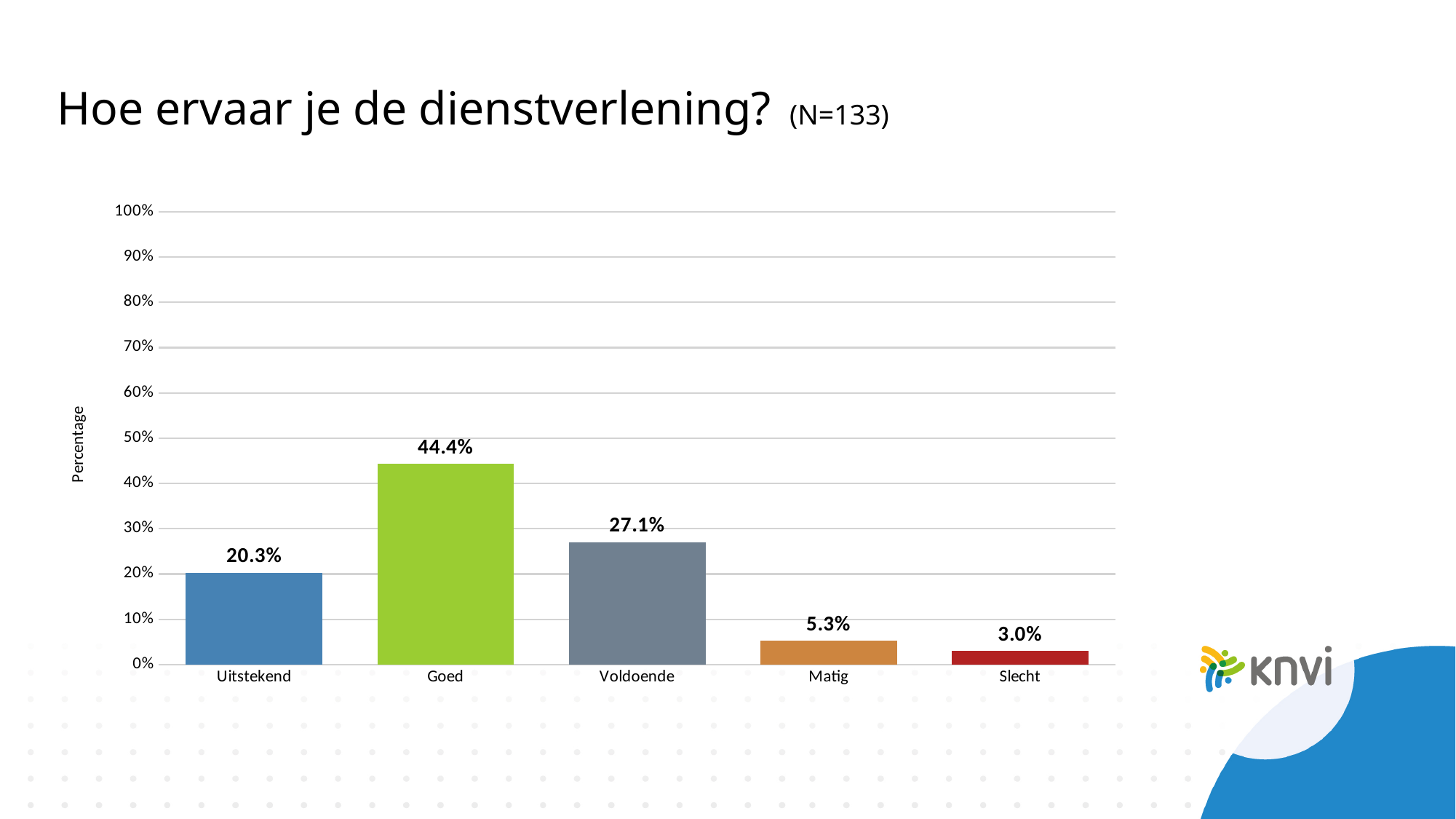
What is the value for Voldoende? 27.1% What kind of chart is shown on the slide? bar chart What is the label of the vertical axis? Percentage What is the difference between the values for Uitstekend and Matig? 15.0% What is the difference between the values for Goed and Voldoende? 17.3% Which category has the lowest value? Slecht Is the value for Goed greater or less than 40%? greater What is the value for Goed? 44.4% Which category has the highest value? Goed What is the value for Slecht? 3.0% Which is larger, the value for Uitstekend or the value for Voldoende? Voldoende How many categories are shown on the x axis? 5